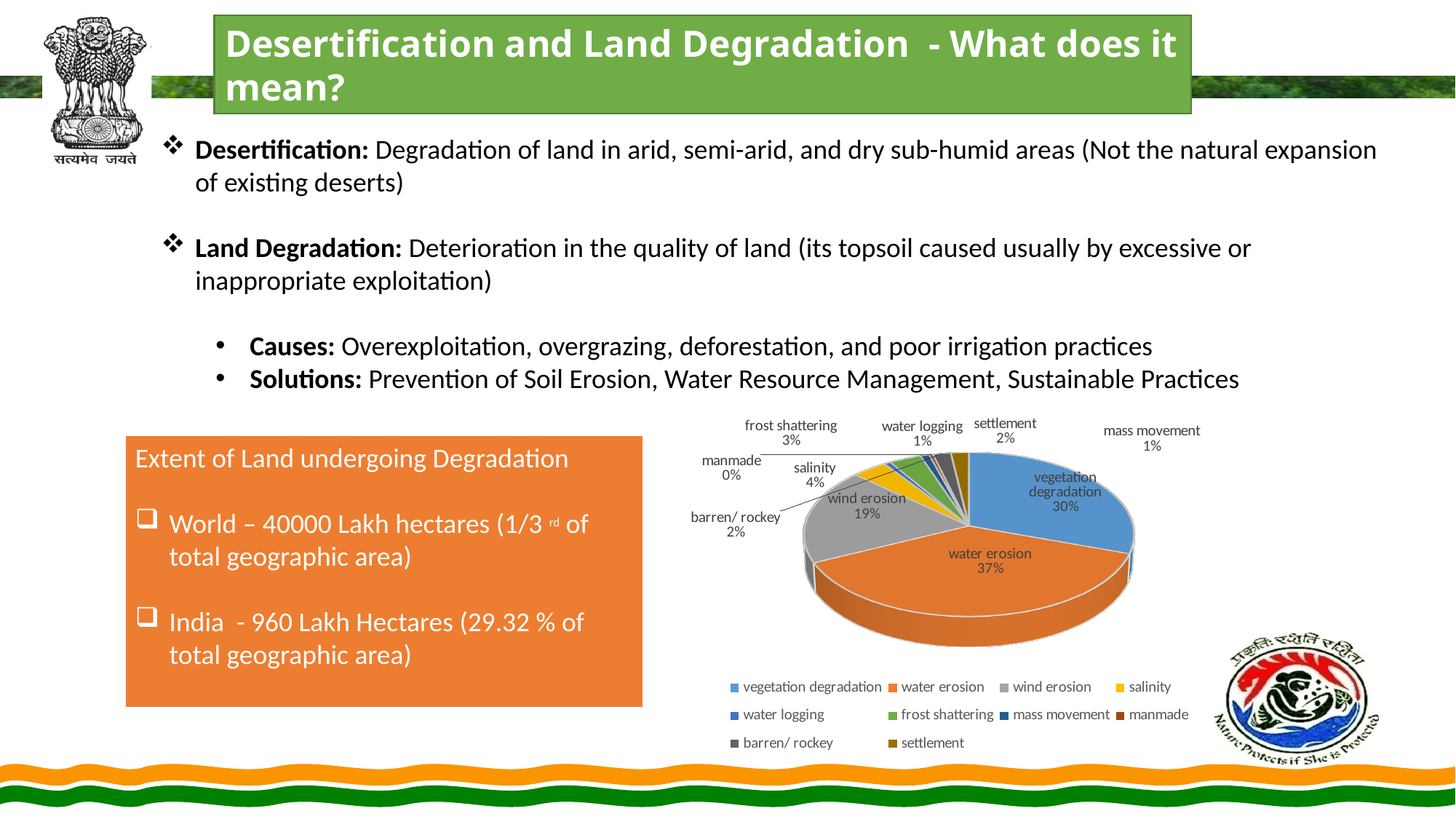
What percentage is shown for salinity? 4% What share of the pie does wind erosion account for? 19% What percentage is shown for manmade? 0% What is the difference in percentage points between water erosion and vegetation degradation? 7 What kind of chart is shown on the slide? pie chart How many categories does the legend of the pie chart list? 10 Which is larger, the share for wind erosion or the share for salinity? wind erosion What share of the pie does water erosion account for? 37% Which category has the smallest slice of the pie? manmade What share of the pie does vegetation degradation account for? 30% What percentage is shown for frost shattering? 3% Which category has the largest slice of the pie? water erosion